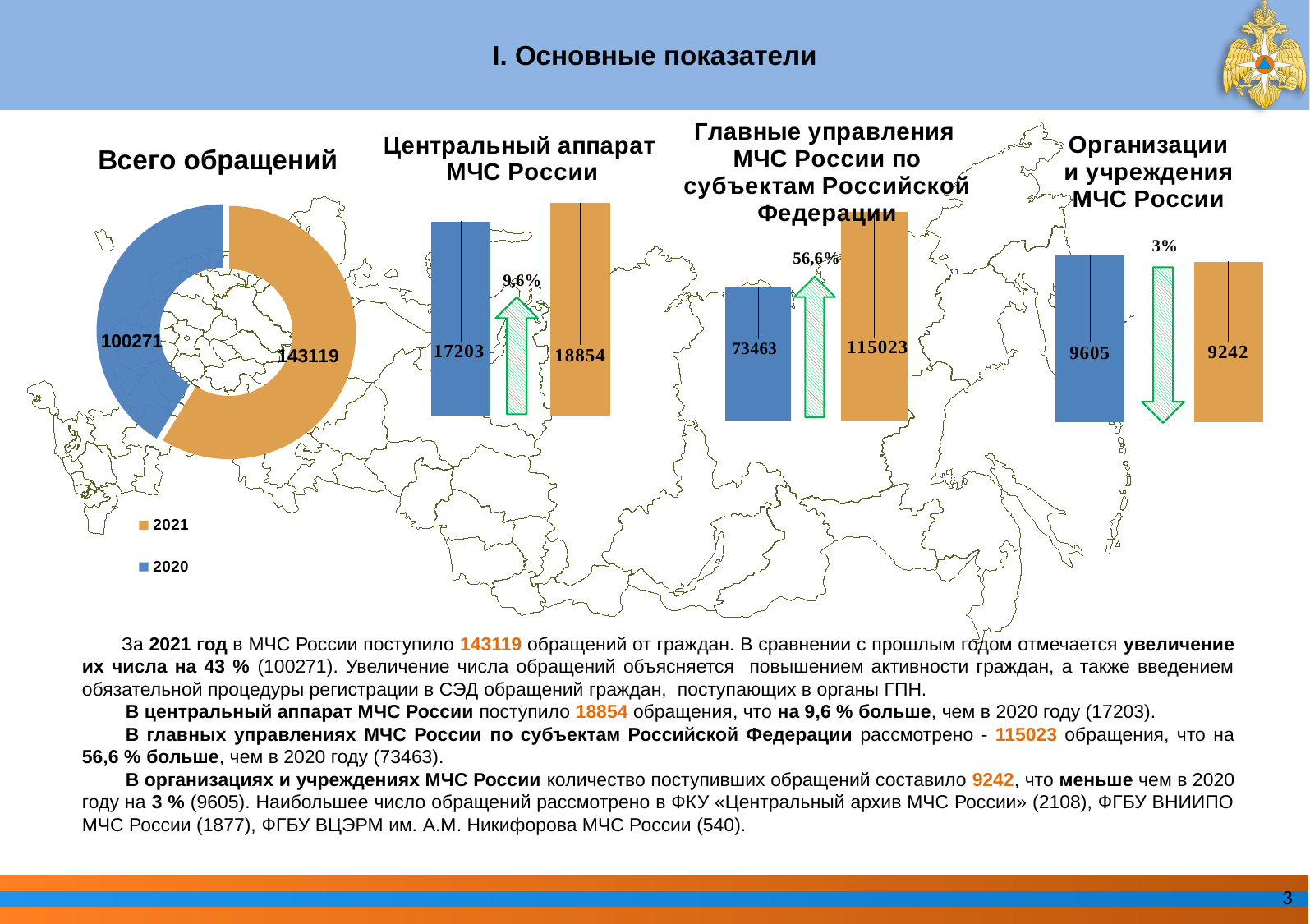
In the 'Центральный аппарат МЧС России' chart, what is the value for 2021? 18854 What kind of chart is 'Всего обращений'? Donut (pie) chart In the 'Всего обращений' chart, what is the value for 2021? 143119 In the 'Всего обращений' chart, what is the difference between the 2021 and 2020 values? 42848 In the 'Центральный аппарат МЧС России' chart, what is the value for 2020? 17203 In the 'Главные управления МЧС России по субъектам Российской Федерации' chart, what is the difference between the 2021 and 2020 values? 41560 In the 'Организации и учреждения МЧС России' chart, which year has the higher value, 2020 or 2021? 2020 In the 'Всего обращений' chart, what is the value for 2020? 100271 How many series does the legend of the 'Всего обращений' chart list? 2 In the 'Организации и учреждения МЧС России' chart, what is the value for 2020? 9605 In the 'Главные управления МЧС России по субъектам Российской Федерации' chart, what is the value for 2021? 115023 In the 'Всего обращений' chart, which year has the larger value, 2020 or 2021? 2021